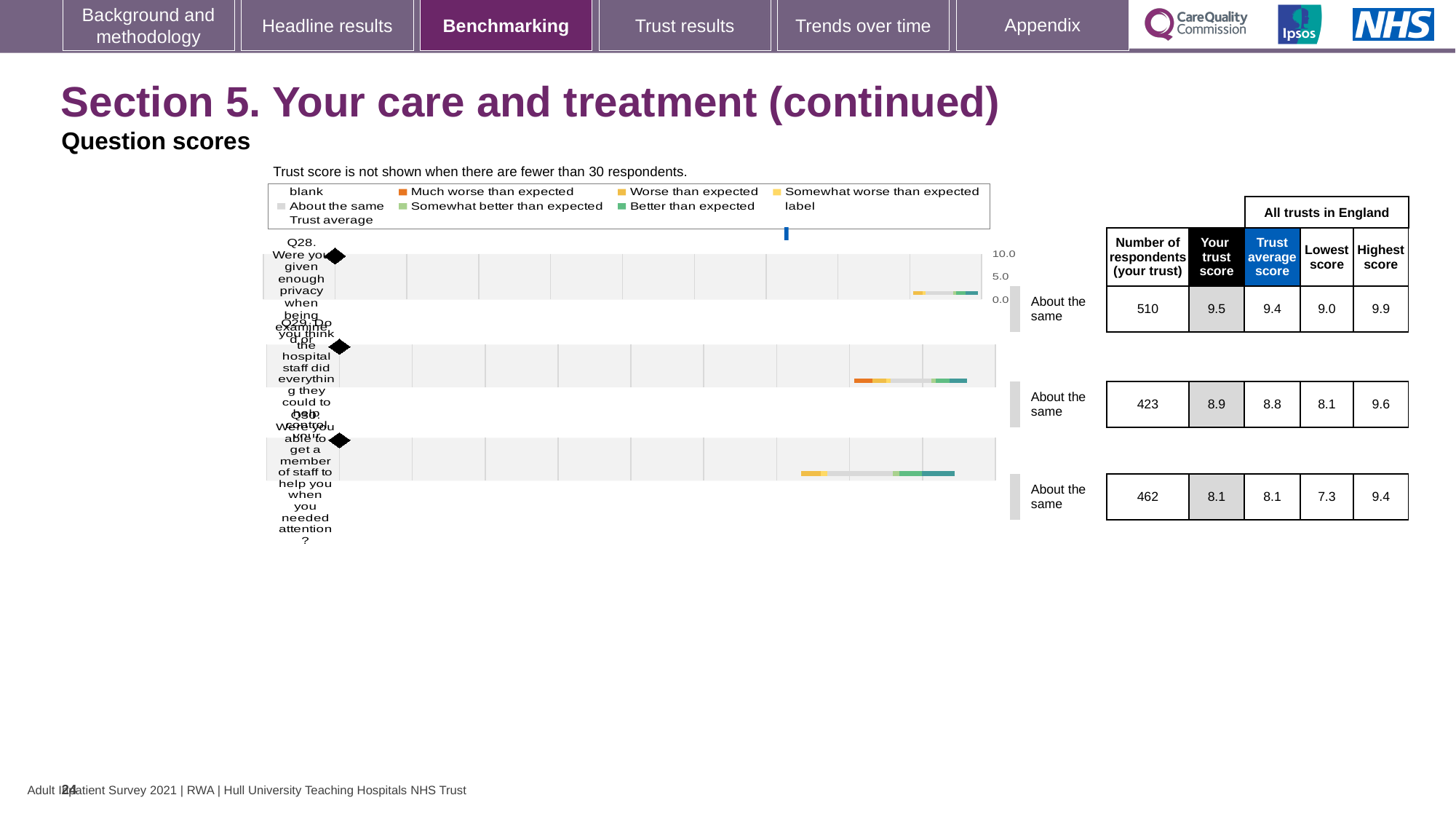
Which question has the lowest trust score on this slide? Q30 What is the lowest score across all trusts in England for Q30? 7.3 What kind of chart is used to show the question scores? Bar chart Is the trust score for Q30 greater or less than 5.0? greater What is the difference between the trust score and the trust average score for Q28? 0.1 Which question has the highest trust score on this slide? Q28 For Q29, which is larger: the trust score or the trust average score? Trust score (8.9) What is the highest score across all trusts in England for Q30? 9.4 How many respondents from the trust answered Q29? 423 What is the trust score for Q28 (Were you given enough privacy when being examined or treated)? 9.5 What benchmark category is shown for Q28? About the same How many questions are plotted on this slide? 3